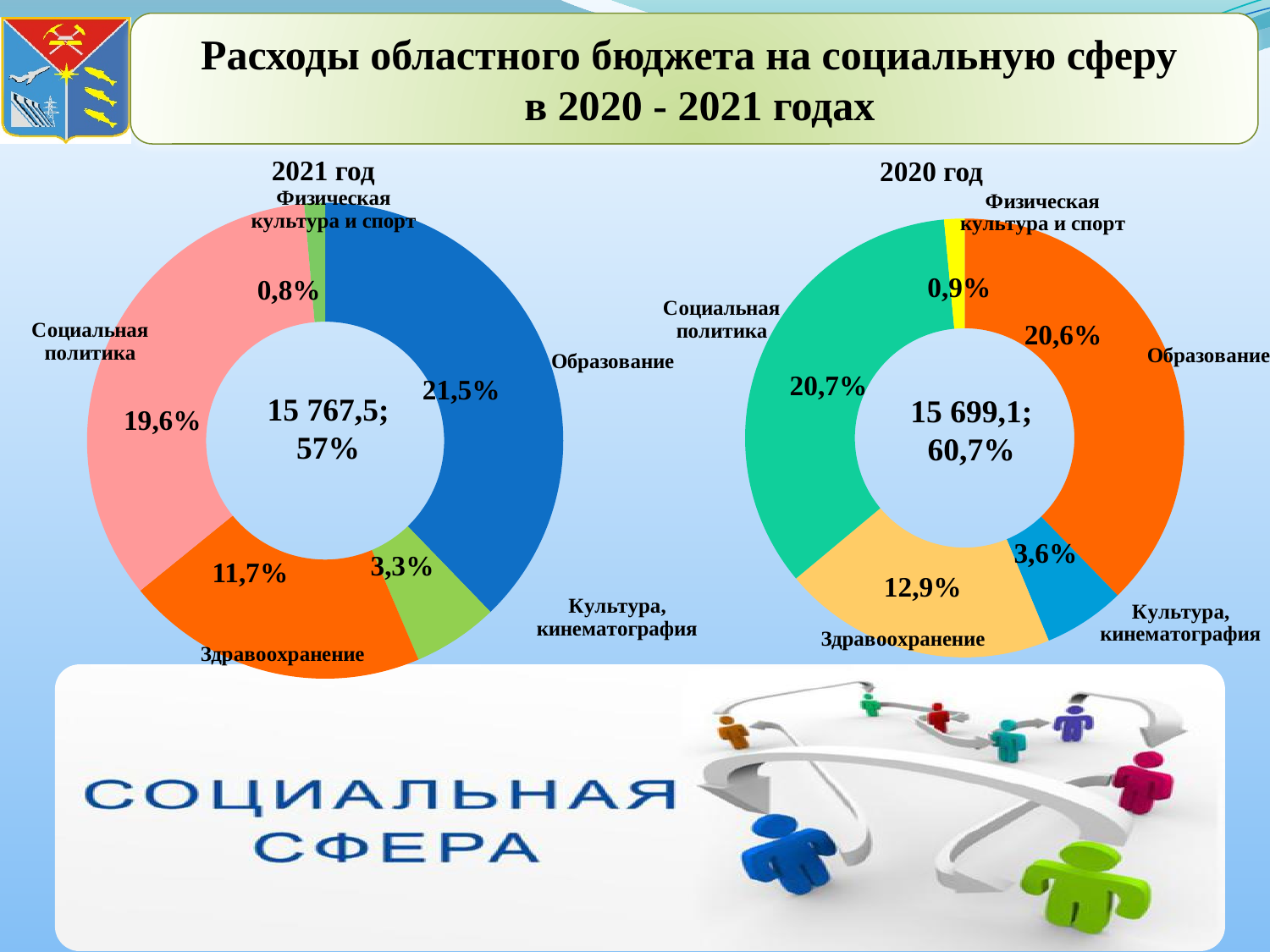
On the 2021 год chart, what is the value for Физическая культура и спорт? 0,8% On the 2021 год chart, which category has the lowest value? Физическая культура и спорт On the 2020 год chart, which is larger: Здравоохранение or Культура, кинематография? Здравоохранение On the 2021 год chart, what is the difference between Образование and Социальная политика? 1,9% What kind of chart is the 2021 год chart? Doughnut (pie) chart What is the title of the slide? Расходы областного бюджета на социальную сферу в 2020 - 2021 годах What text is shown in the centre of the 2020 год chart? 15 699,1; 60,7% On the 2020 год chart, what is the value for Здравоохранение? 12,9% On the 2021 год chart, what is the value for Культура, кинематография? 3,3% On the 2021 год chart, what is the value for Образование? 21,5% How many categories are shown on the 2020 год chart? 5